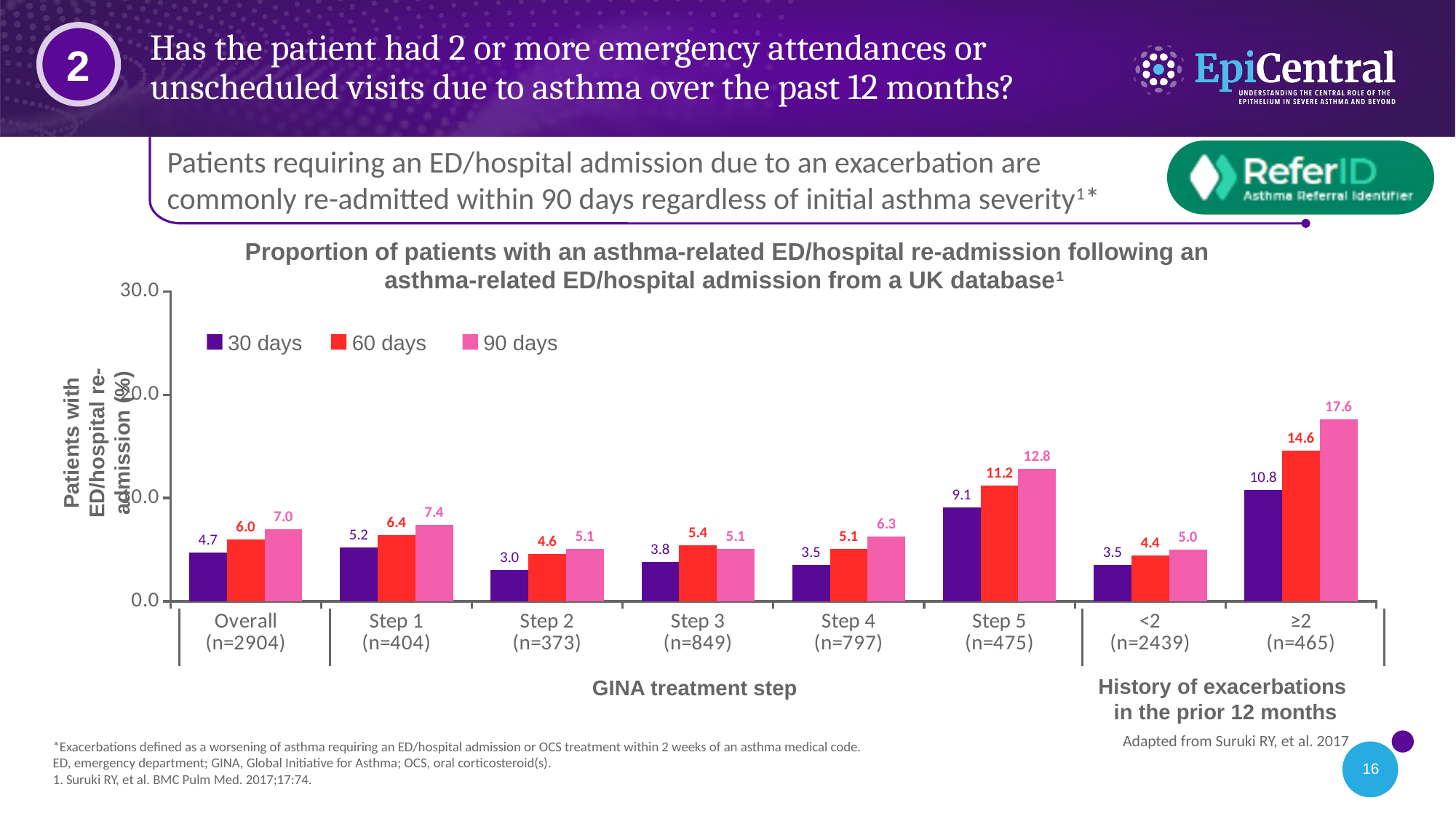
What is the difference between the 90 days and 30 days values for Step 5 (n=475)? 3.7 What is the label of the y axis? Patients with ED/hospital re-admission (%) What is the 60 days value for the Overall (n=2904) category? 6.0 Is the 60 days value for ≥2 (n=465) greater or less than 10.0? greater How many series does the legend list? 3 How many categories are shown on the x axis? 8 What kind of chart is shown on the slide? Bar chart What is the 30 days value for Step 5 (n=475)? 9.1 Which category has the highest 90 days value? ≥2 (n=465) Which is larger for Step 3 (n=849): the 60 days value or the 90 days value? 60 days Which category has the lowest 30 days value? Step 2 (n=373) What is the 90 days value for the ≥2 (n=465) category? 17.6